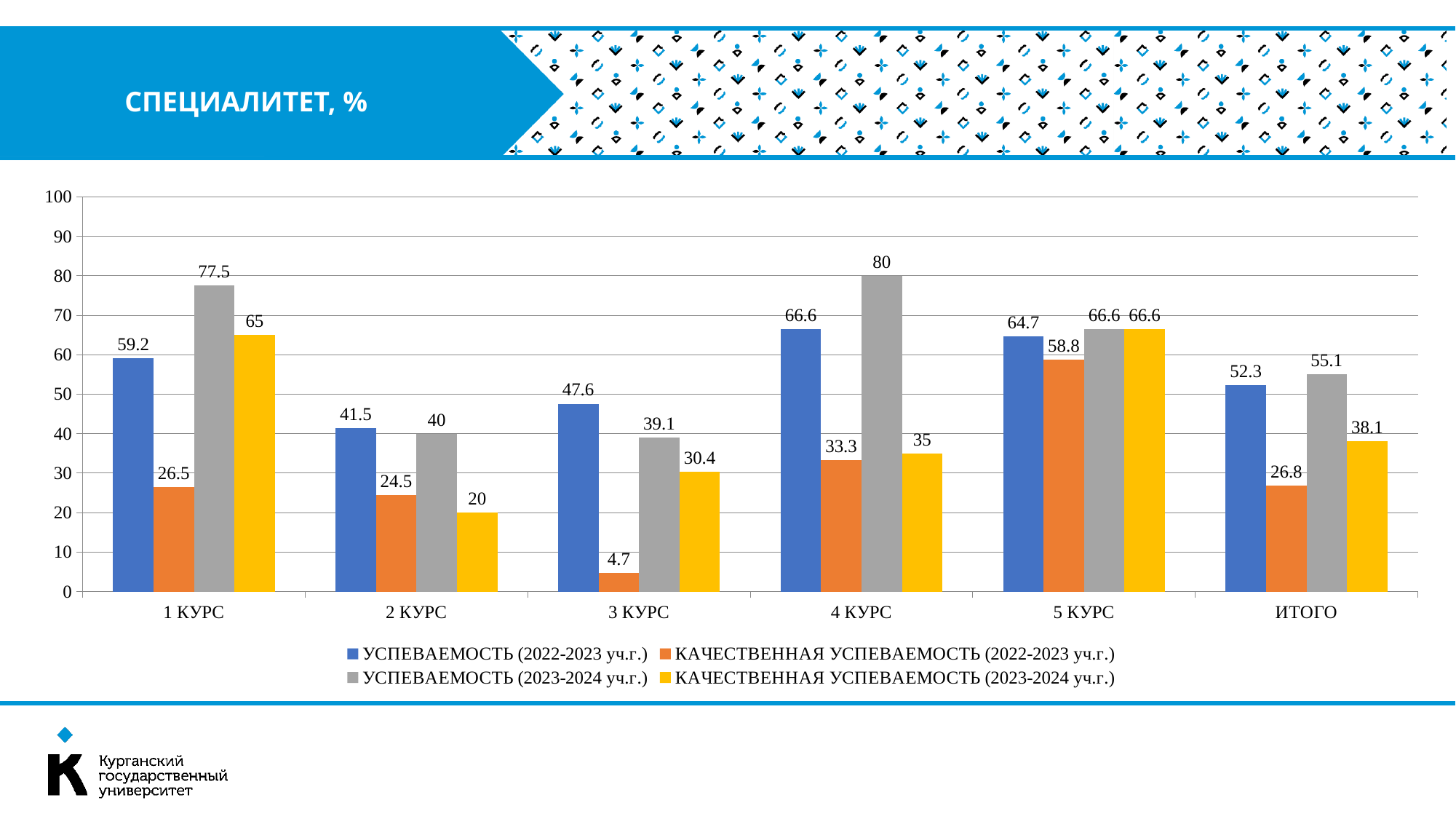
What kind of chart is shown on the slide? Bar chart How many categories are shown on the x axis? 6 Which category has the lowest value for КАЧЕСТВЕННАЯ УСПЕВАЕМОСТЬ (2022-2023 уч.г.)? 3 КУРС How many series does the legend list? 4 Is the value of КАЧЕСТВЕННАЯ УСПЕВАЕМОСТЬ (2023-2024 уч.г.) for 5 КУРС greater or less than 60? greater Which category has the highest value for УСПЕВАЕМОСТЬ (2023-2024 уч.г.)? 4 КУРС What is the value of УСПЕВАЕМОСТЬ (2023-2024 уч.г.) for 1 КУРС? 77.5 What is the value of КАЧЕСТВЕННАЯ УСПЕВАЕМОСТЬ (2023-2024 уч.г.) for ИТОГО? 38.1 What is the value of КАЧЕСТВЕННАЯ УСПЕВАЕМОСТЬ (2022-2023 уч.г.) for 3 КУРС? 4.7 What is the difference between УСПЕВАЕМОСТЬ (2023-2024 уч.г.) and УСПЕВАЕМОСТЬ (2022-2023 уч.г.) for 4 КУРС? 13.4 What is the title of the slide? СПЕЦИАЛИТЕТ, % Which is larger for 2 КУРС: УСПЕВАЕМОСТЬ (2022-2023 уч.г.) or УСПЕВАЕМОСТЬ (2023-2024 уч.г.)? УСПЕВАЕМОСТЬ (2022-2023 уч.г.)